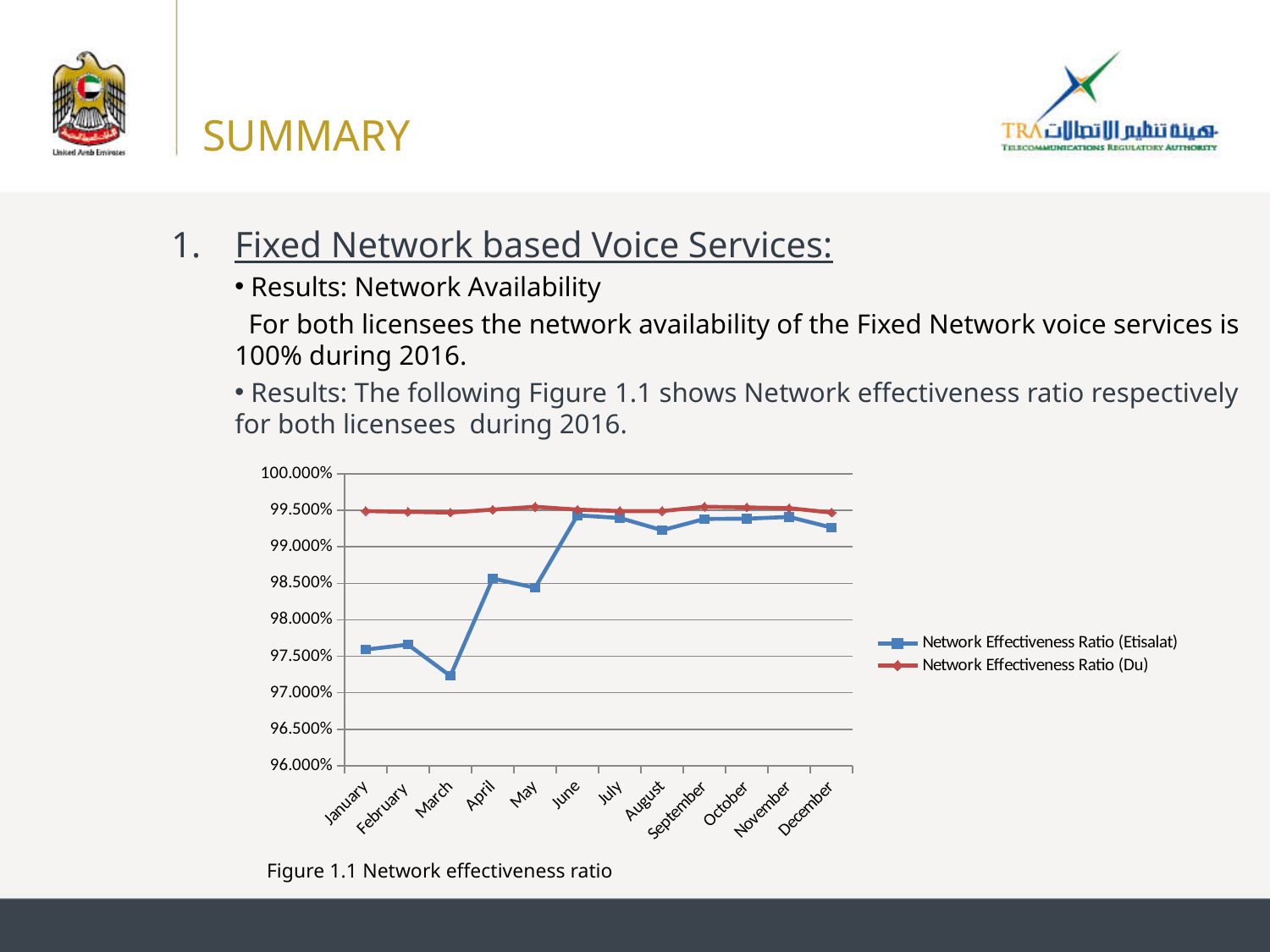
Does the Network Effectiveness Ratio (Etisalat) rise or fall from March to June? rise Is the Network Effectiveness Ratio (Du) for January greater or less than 99.000%? greater Is the Network Effectiveness Ratio (Etisalat) for April greater or less than 98.000%? greater Is the Network Effectiveness Ratio (Etisalat) for March greater or less than 97.500%? less In March, which series has the higher value: Network Effectiveness Ratio (Etisalat) or Network Effectiveness Ratio (Du)? Network Effectiveness Ratio (Du) In which month is the Network Effectiveness Ratio (Etisalat) lowest? March What is the caption given below the chart? Figure 1.1 Network effectiveness ratio What kind of chart is shown in Figure 1.1? line chart Which series is drawn in red in the chart? Network Effectiveness Ratio (Du) How many months are plotted along the x axis of the chart? 12 How many series does the legend of the chart list? 2